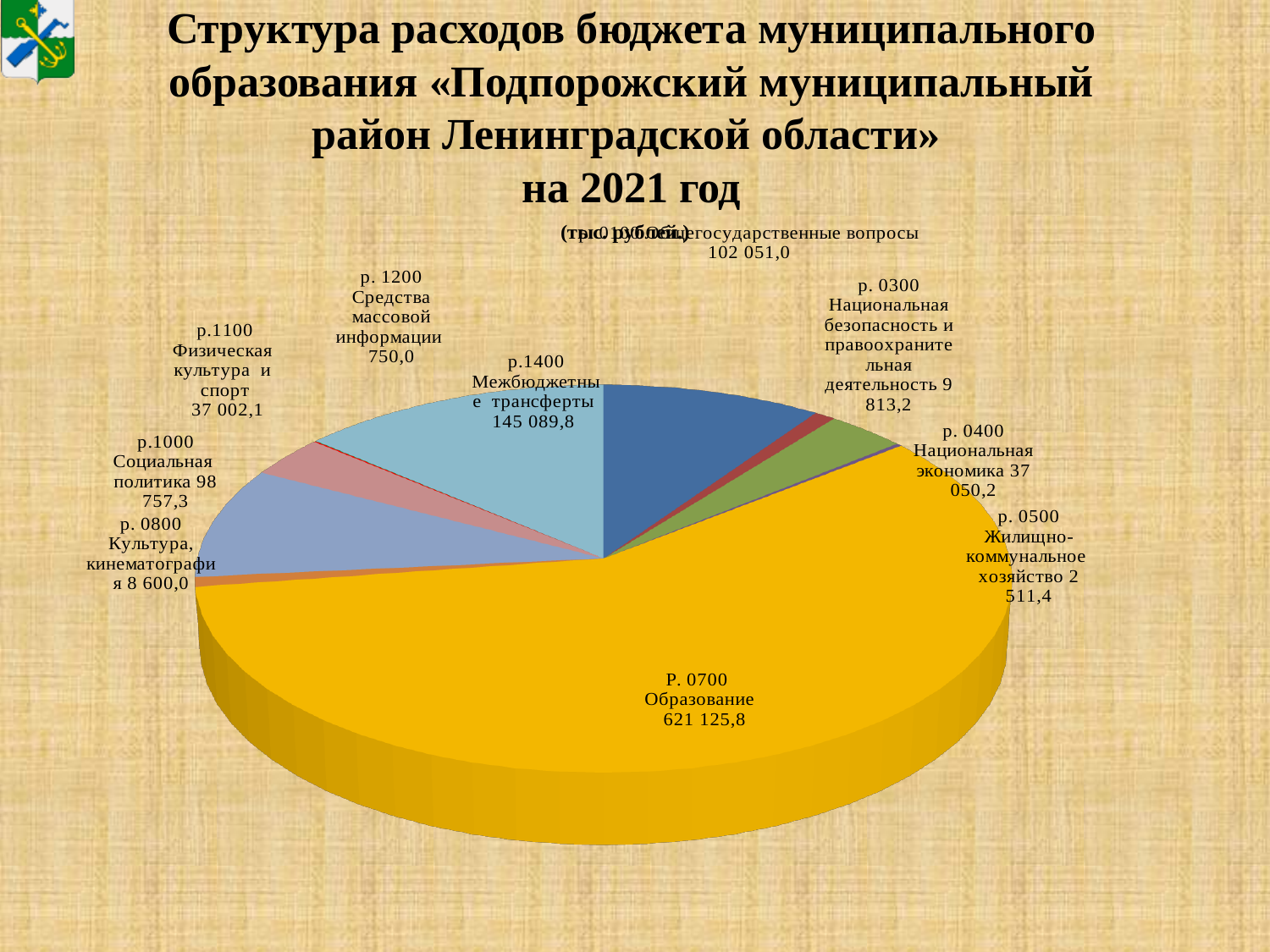
What is the difference between р.1000 Социальная политика and р. 0800 Культура, кинематография? 90 157,3 In what units are the values on the chart given, according to the slide? тыс. рублей Which is larger: р. 0100 Общегосударственные вопросы or р.1000 Социальная политика? р. 0100 Общегосударственные вопросы What is the difference between р.1400 Межбюджетные трансферты and р. 0100 Общегосударственные вопросы? 43 038,8 What is the value for р.1000 Социальная политика? 98 757,3 What kind of chart is shown on the slide? Pie chart What is the value for р.1400 Межбюджетные трансферты? 145 089,8 What is the value for Р. 0700 Образование? 621 125,8 Which category has the largest value in the pie chart? Р. 0700 Образование What is the value for р. 0500 Жилищно-коммунальное хозяйство? 2 511,4